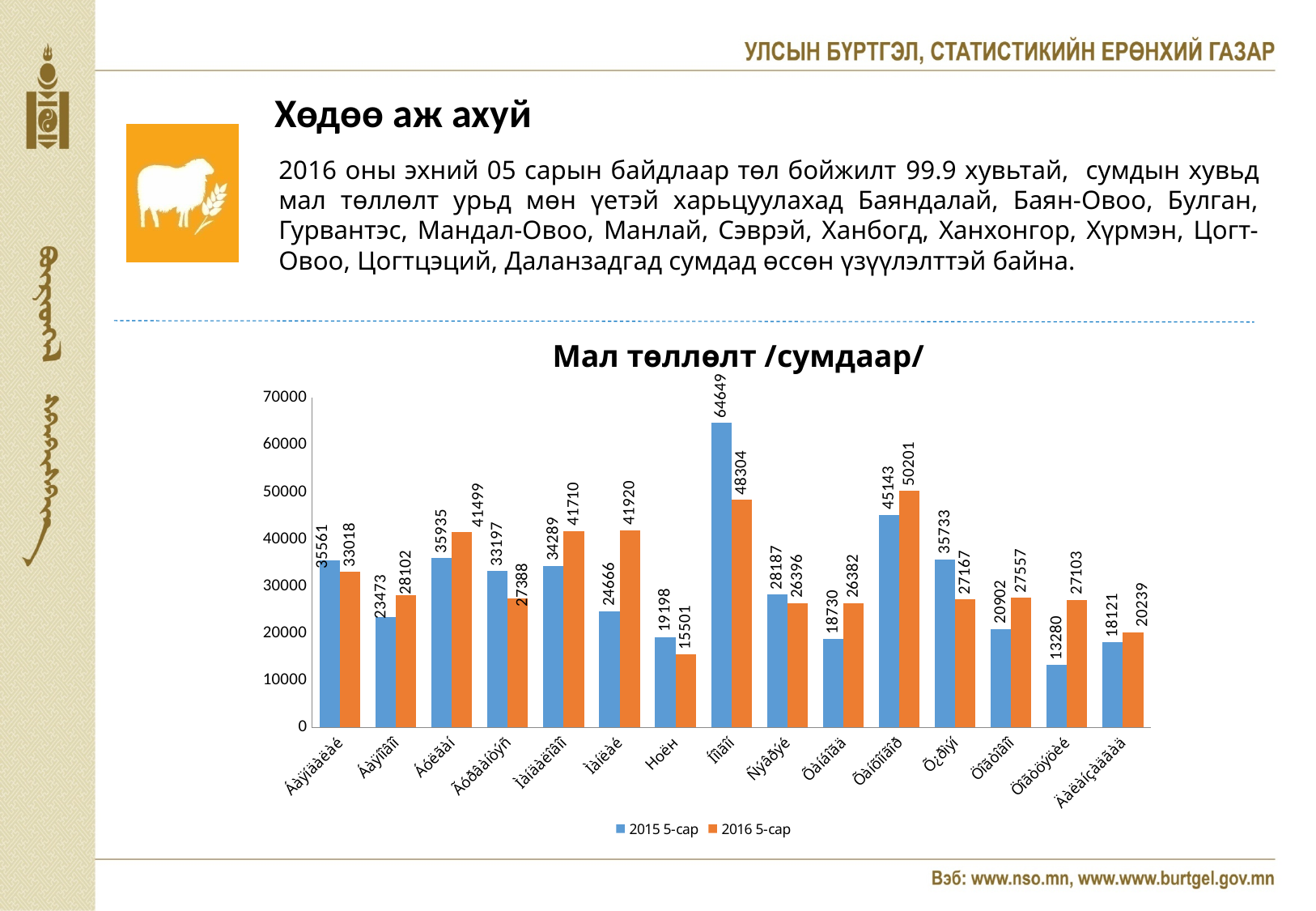
What is the 2016 5-сар value for Ноён? 15501 What is the title of the chart? Мал төллөлт /сумдаар/ Is the 2016 5-сар value for Ноён greater or less than 20000? less What is the highest value in the 2016 5-сар series? 50201 Which category has the lowest 2016 5-сар value? Ноён What is the 2015 5-сар value for Ноён? 19198 For Ноён, which series has the larger value, 2015 5-сар or 2016 5-сар? 2015 5-сар How many series does the legend of the chart list? 2 What kind of chart is shown on the slide? bar chart What is the difference between the 2015 5-сар and 2016 5-сар values for Ноён? 3697 How many categories are plotted along the x axis of the chart? 15 What is the highest value in the 2015 5-сар series? 64649